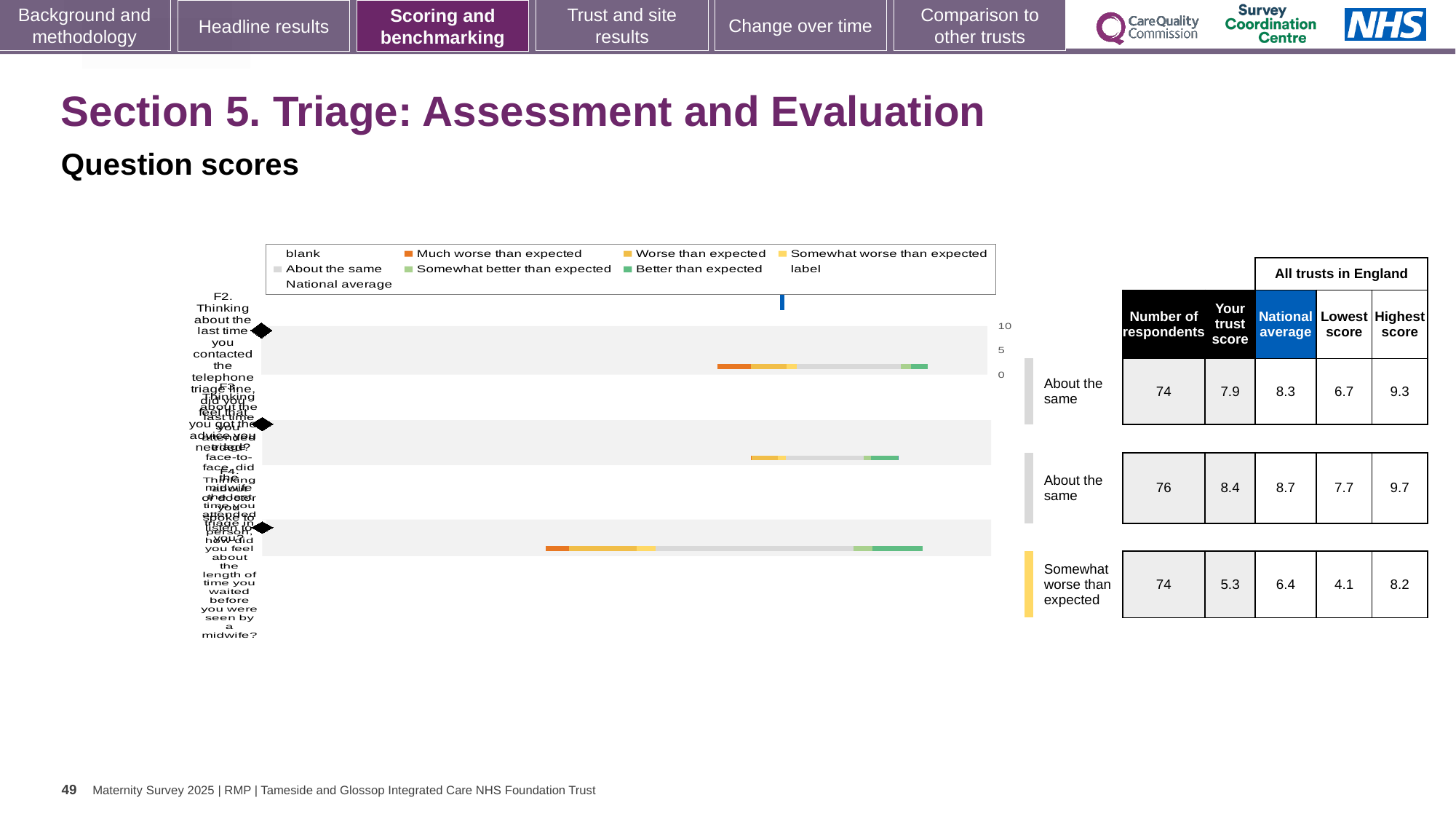
In the chart legend, what colour represents 'Better than expected'? green In the table beside the chart, what is 'Your trust score' for the third row (Somewhat worse than expected)? 5.3 In the table beside the chart, which row has the lowest 'Your trust score'? the third row (5.3) How many question rows (bars) does the chart show? 3 In the table beside the chart, what is the national average for the third row (Somewhat worse than expected)? 6.4 What kind of chart is shown on the slide? bar chart In the table beside the chart, what is the lowest score for the first row? 6.7 In the table beside the chart, what is the highest score for the second row? 9.7 In the table beside the chart, what is the difference between the national average and 'Your trust score' for the third row? 1.1 In the chart legend, what colour represents 'Much worse than expected'? orange In the table beside the chart, what is the number of respondents for the second row? 76 In the table beside the chart, which row has the highest 'Your trust score'? the second row (8.4)